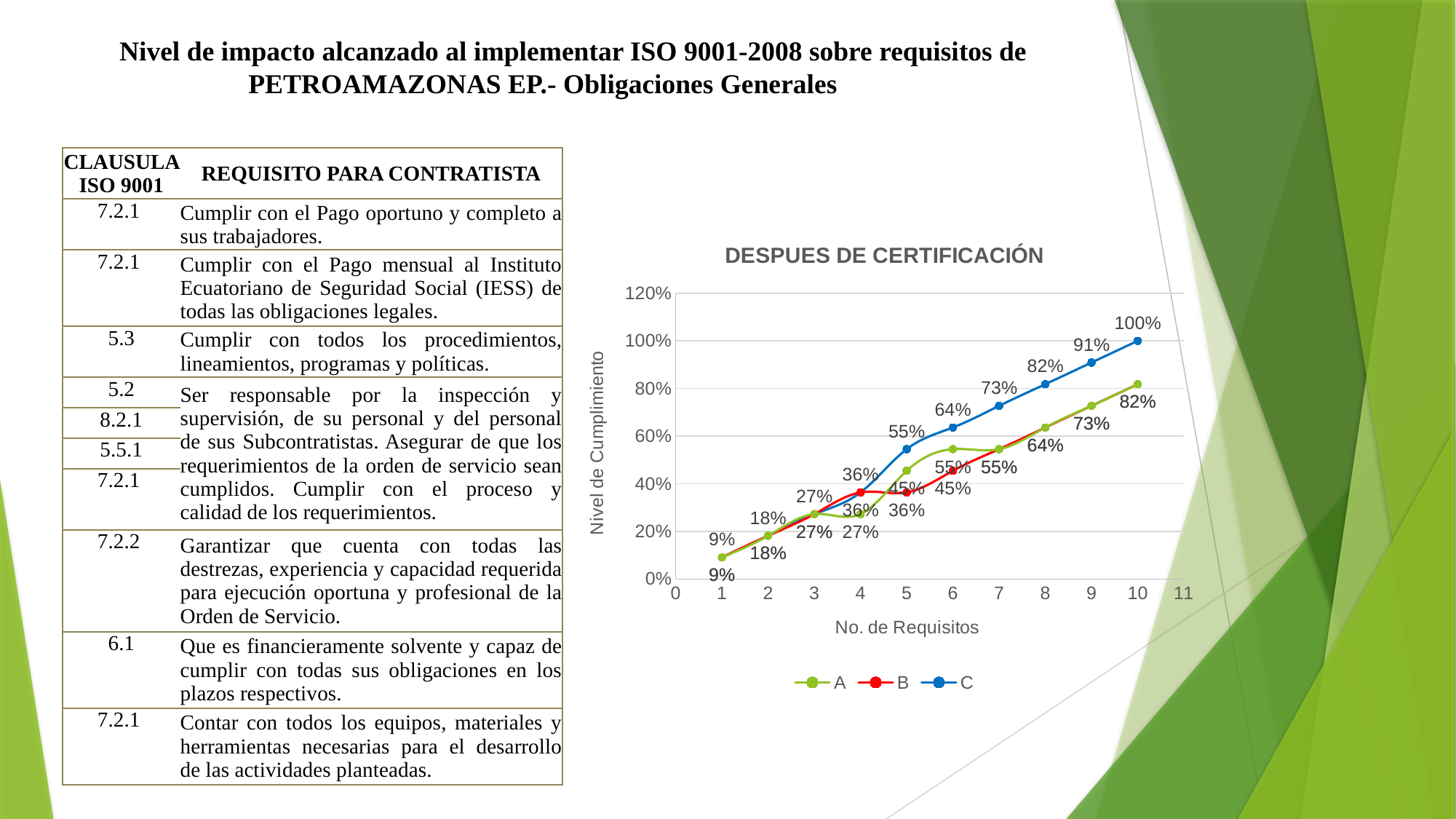
How many series does the chart legend list? 3 What is the title of the chart? DESPUES DE CERTIFICACIÓN What kind of chart is shown on the slide? line chart What is the value of series C at requisito 5? 55% At requisito 5, which series has the larger value, A or C? C Do the values of series C rise or fall as the number of requisitos increases? rise What is the value of series C at requisito 10? 100% What is the value of series B at requisito 4? 36% What is the value of series A at requisito 10? 82% What is the difference between series C and series A at requisito 10? 18% Which series has the highest value at requisito 10? C What is the label of the x axis of the chart? No. de Requisitos